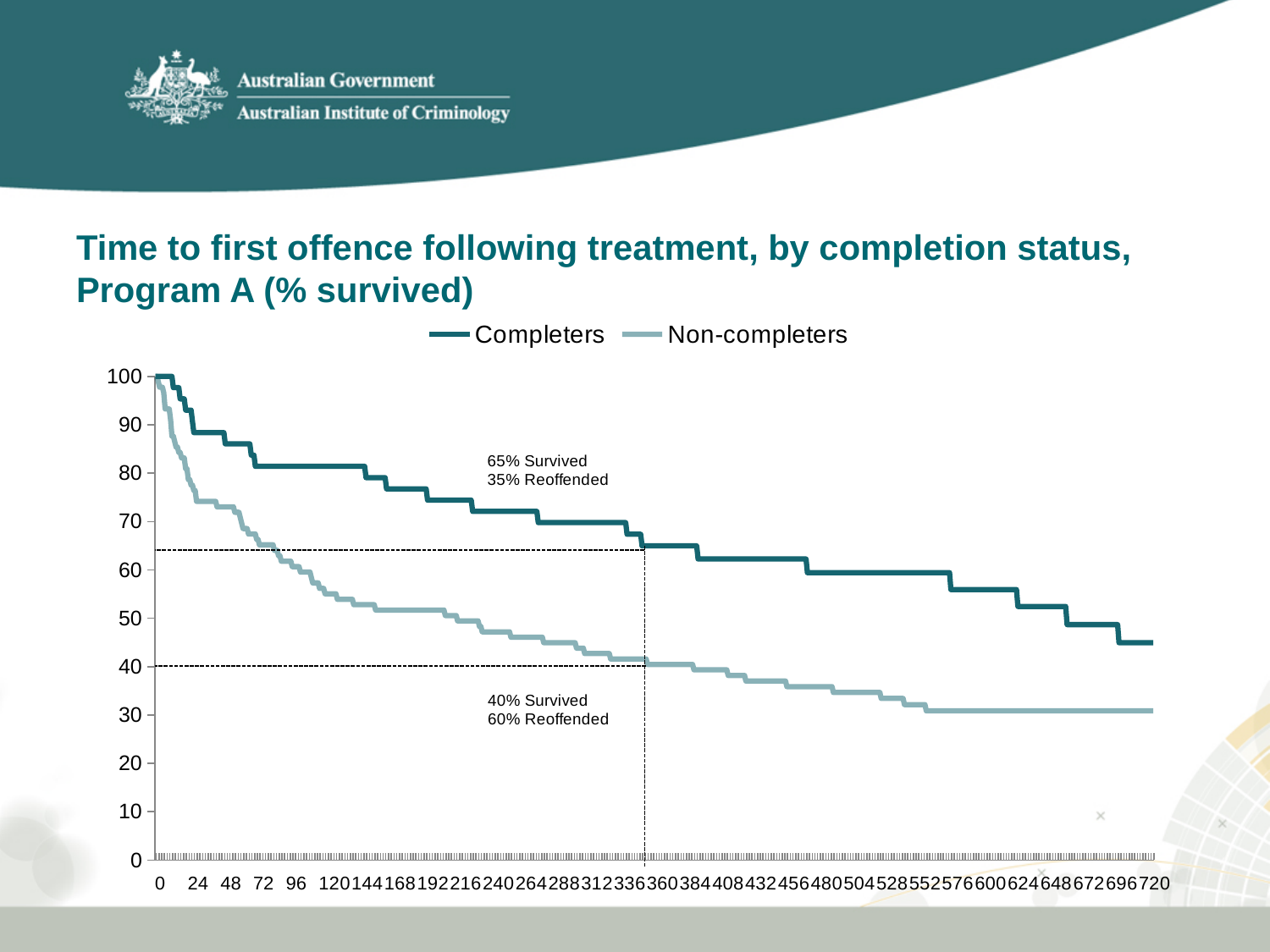
What is the title of the chart? Time to first offence following treatment, by completion status, Program A (% survived) What kind of chart is shown on the slide? line chart Is the value for Non-completers at 720 greater or less than 40? less Do the values for both series rise or fall as you move along the x axis? fall Is the value for Completers at 720 greater or less than 40? greater According to the annotation at the dashed vertical line, what percentage of Non-completers had survived? 40% What is the difference in percentage points between the survived share of Completers (65%) and Non-completers (40%) shown in the annotations? 25 How many series does the legend list? 2 According to the annotation, what percentage of Non-completers had reoffended at the dashed vertical line? 60% Which series has the higher value at the right end of the chart (720), Completers or Non-completers? Completers According to the annotation at the dashed vertical line, what percentage of Completers had survived? 65% What are the two series named in the legend? Completers and Non-completers